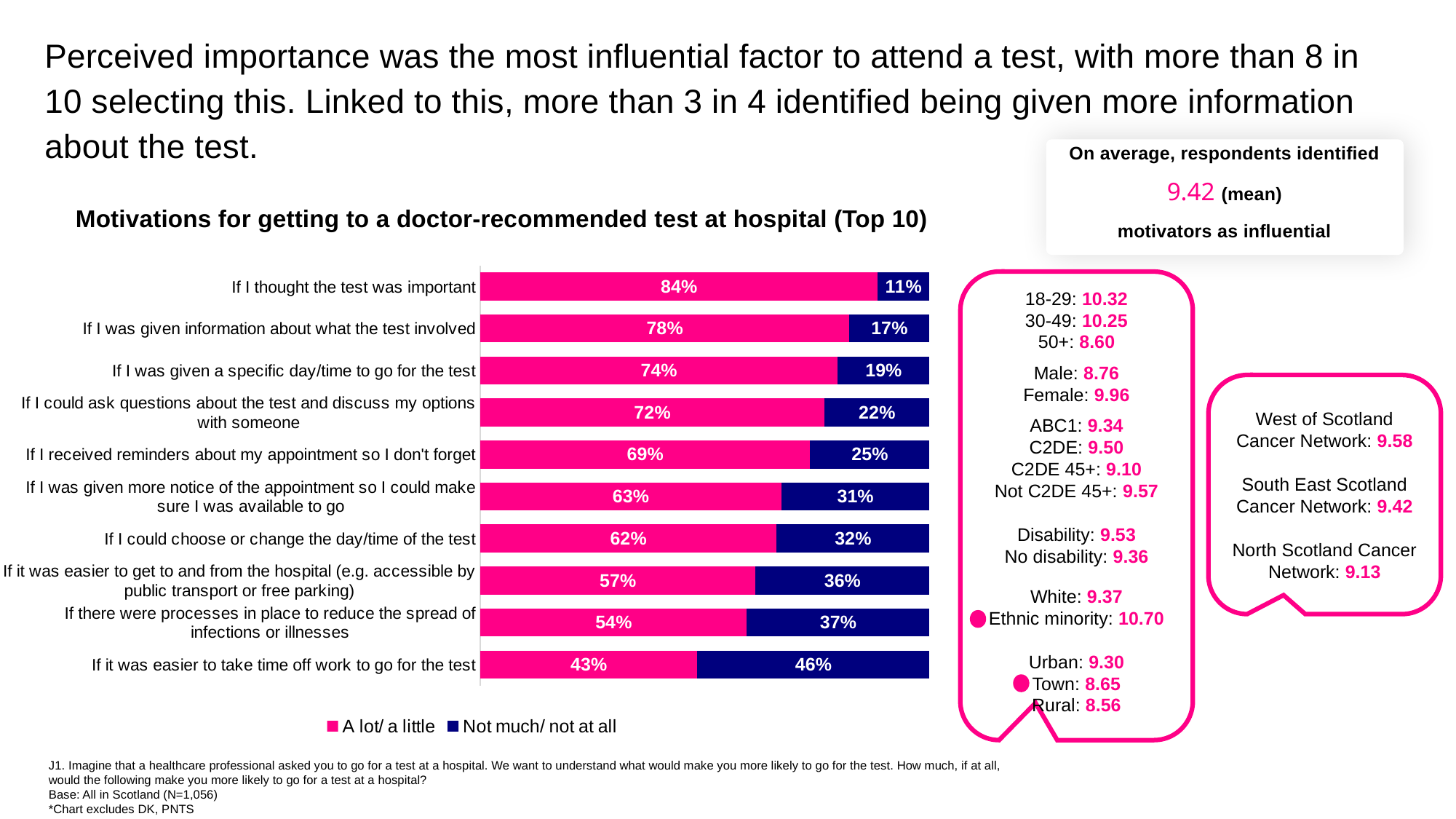
What is the difference between the 'A lot/ a little' values for 'If I was given information about what the test involved' and 'If I was given a specific day/time to go for the test'? 4 percentage points What type of chart is used to show the motivations? Stacked bar chart How many motivations are shown in the chart? 10 What percentage said 'A lot/ a little' for 'If I thought the test was important'? 84% What percentage said 'Not much/ not at all' for 'If it was easier to take time off work to go for the test'? 46% Which is larger: the 'Not much/ not at all' value for 'If I could choose or change the day/time of the test' or for 'If there were processes in place to reduce the spread of infections or illnesses'? If there were processes in place to reduce the spread of infections or illnesses What is the total of the two segments for 'If I could ask questions about the test and discuss my options with someone'? 94% What is the title of the chart? Motivations for getting to a doctor-recommended test at hospital (Top 10) Which motivation has the highest 'A lot/ a little' percentage? If I thought the test was important What is the 'A lot/ a little' value for 'If I received reminders about my appointment so I don't forget'? 69% How many series does the legend list? 2 Which motivation has the lowest 'A lot/ a little' percentage? If it was easier to take time off work to go for the test